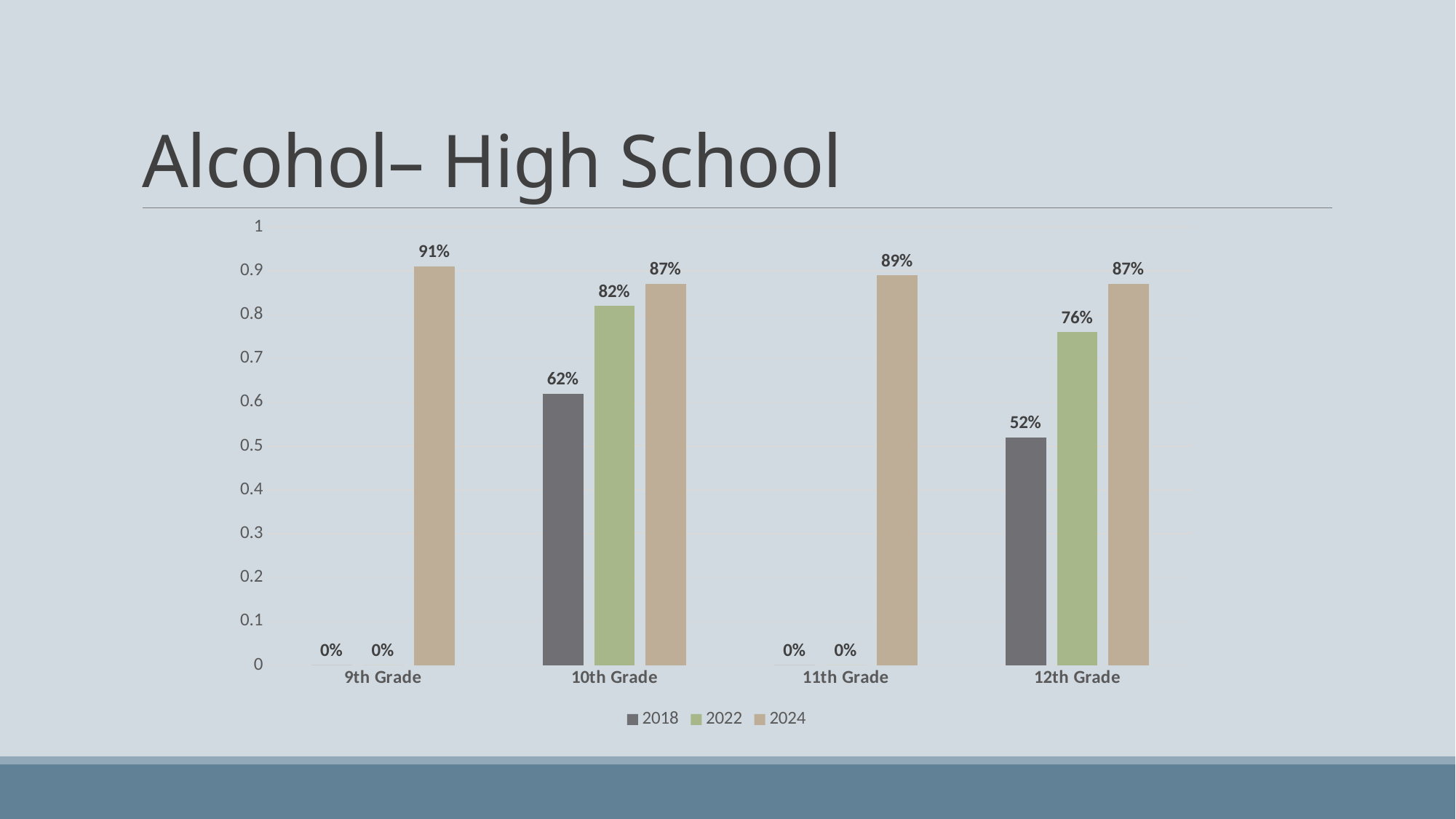
How many grade categories are shown on the x axis? 4 What is the value for 2018 for 10th Grade? 62% What is the value for 2024 for 11th Grade? 89% Which is larger, the 2022 value for 10th Grade or the 2022 value for 12th Grade? 10th Grade What is the difference between the 2022 values for 10th Grade and 12th Grade? 6% What kind of chart is shown on the slide? Bar chart What is the difference between the 2024 and 2018 values for 12th Grade? 35% Which grade has the lowest 2018 value among those with a non-zero bar? 12th Grade Which grade has the highest 2024 value? 9th Grade What is the value for 2022 for 12th Grade? 76% How many series does the legend list? 3 What is the value for 2024 for 9th Grade? 91%